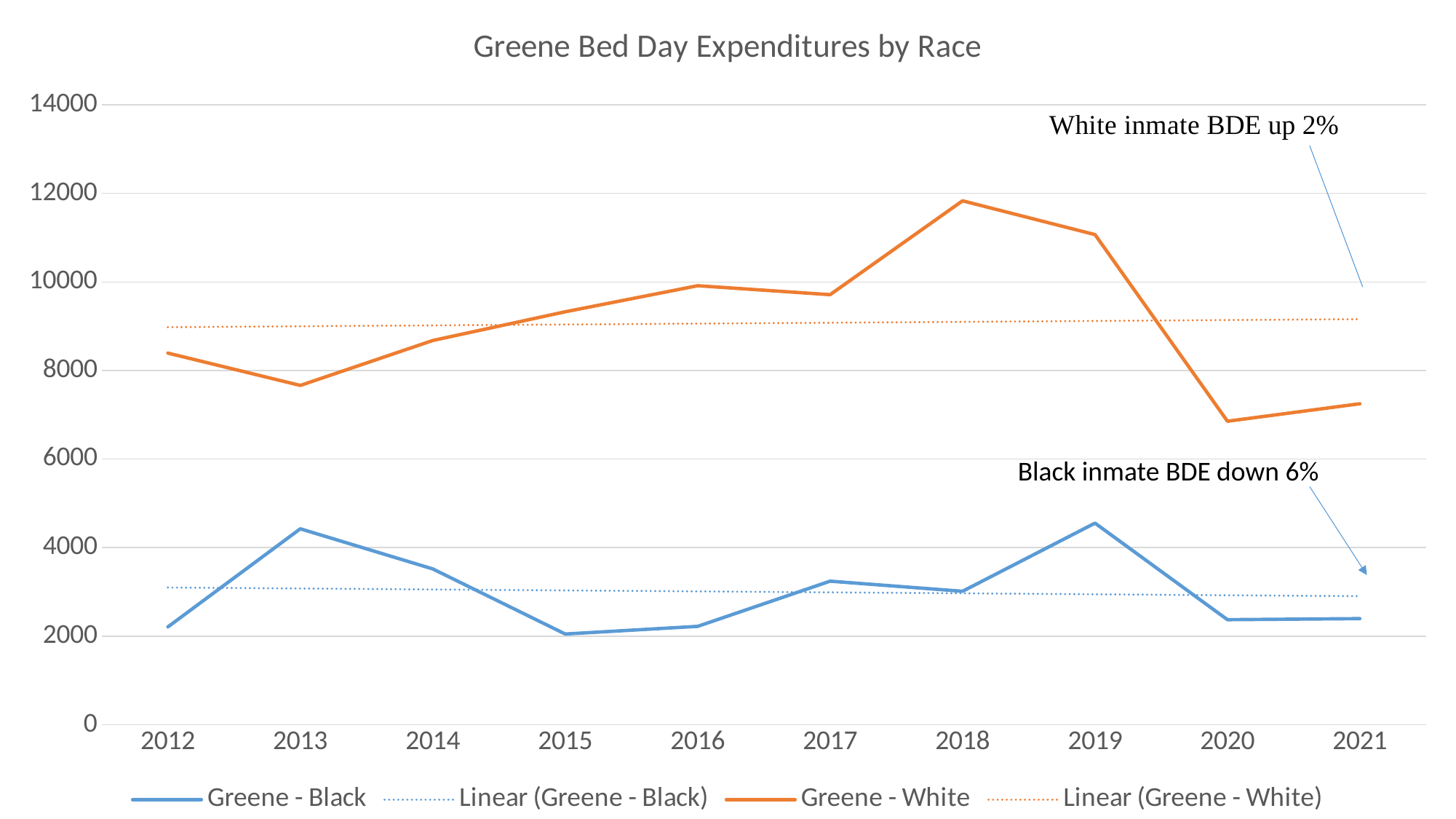
In which year does the Greene - White series reach its lowest value? 2020 In which year does the Greene - White series reach its highest value? 2018 Is the Greene - White value for 2020 greater or less than 8000? less Which series has the larger value in 2018, Greene - Black or Greene - White? Greene - White Is the Greene - White value for 2018 greater or less than 10000? greater Is the Greene - Black value for 2015 greater or less than 4000? less According to the annotation on the chart, by what percentage is Black inmate BDE down? 6% What is the title of the chart? Greene Bed Day Expenditures by Race Does the Greene - White series rise or fall from 2019 to 2020? fall How many entries does the legend list? 4 What type of chart is shown on the slide? line chart How many years are shown along the x axis? 10